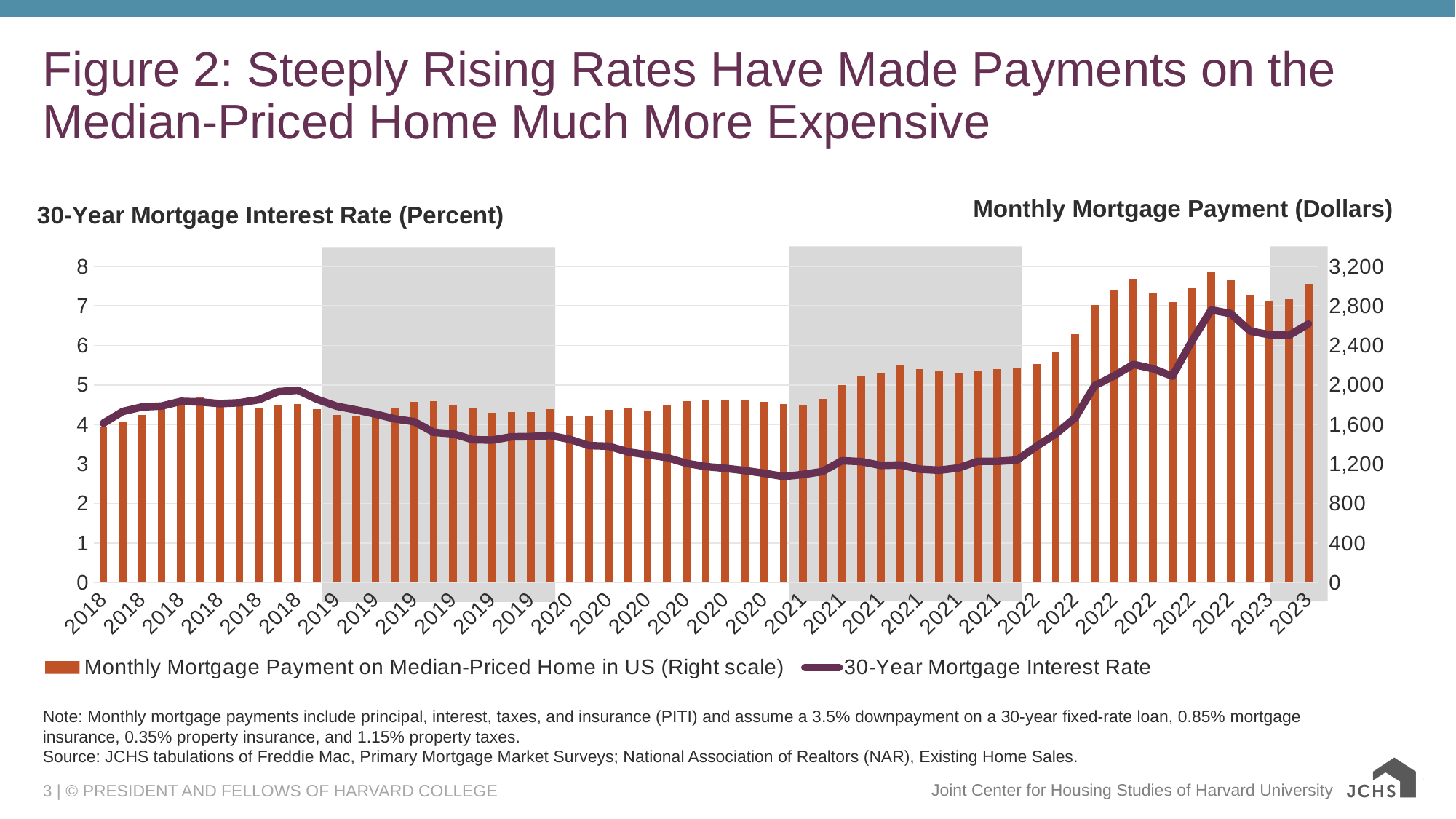
Is the 30-Year Mortgage Interest Rate higher at the last 2023 point or at the first 2018 point? The last 2023 point In which year does the 30-Year Mortgage Interest Rate line reach its lowest point? 2020 How many series does the legend list? 2 Is the tallest monthly mortgage payment bar greater or less than 3,000? greater In which year does the tallest monthly mortgage payment bar occur? 2022 Is the 30-Year Mortgage Interest Rate at the last 2023 point greater or less than 6? greater What kind of chart is shown on the slide? A combination bar and line chart Which series is plotted on the right scale according to the legend? Monthly Mortgage Payment on Median-Priced Home in US Is the lowest point of the 30-Year Mortgage Interest Rate line greater or less than 3? less What is the title of the right-hand axis? Monthly Mortgage Payment (Dollars) How many bars are plotted in the chart? 63 Does the 30-Year Mortgage Interest Rate line rise or fall from 2021 to 2023? Rise